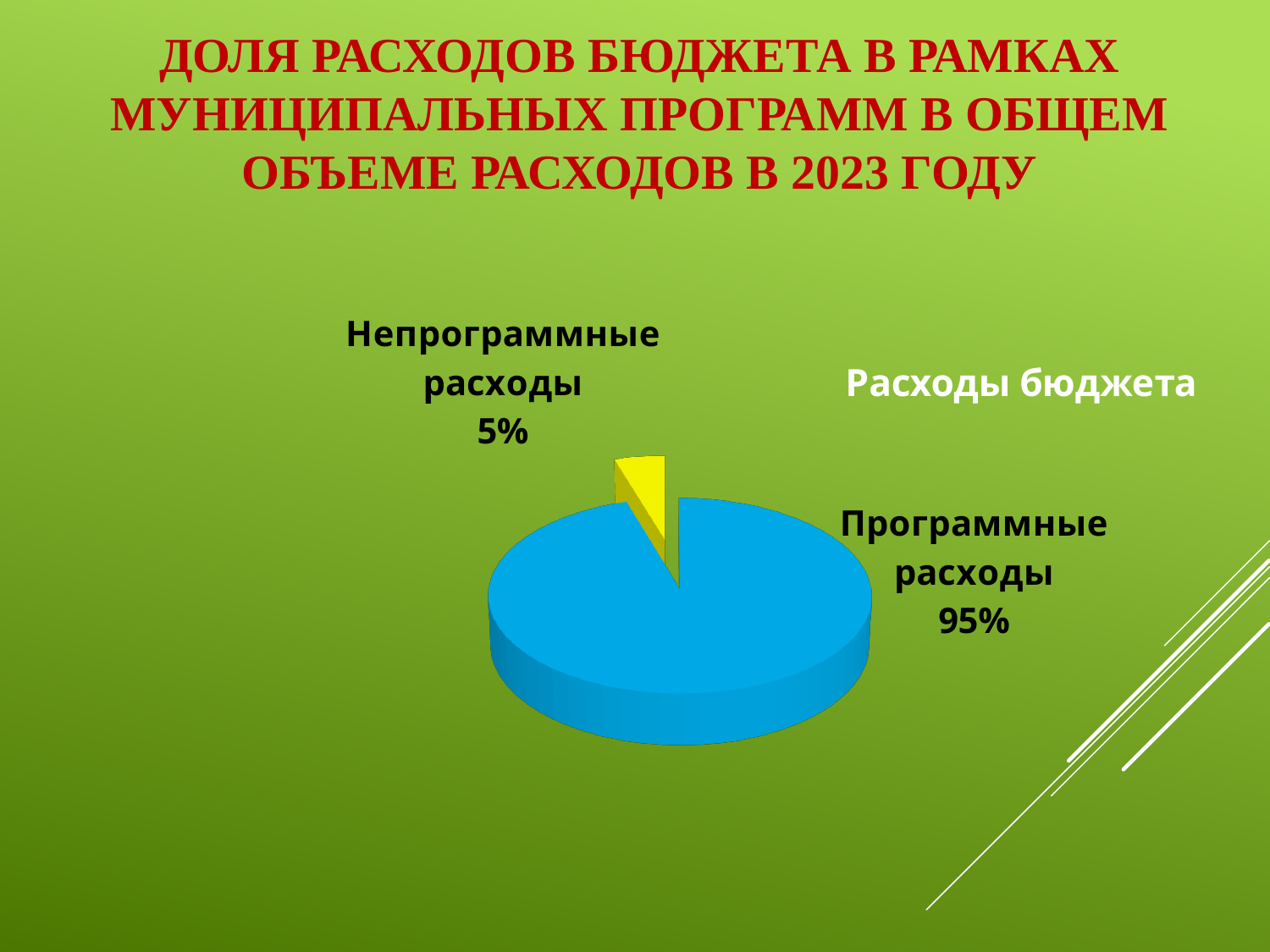
Which category has the smallest slice of the pie? Непрограммные расходы What is the title of the chart? Расходы бюджета What kind of chart is shown on the slide? Pie chart What share of the pie is labelled for Непрограммные расходы? 5% What colour is the slice for Непрограммные расходы? Yellow What is the total of the two labelled shares in the pie? 100% What is the difference in percentage points between Программные расходы and Непрограммные расходы? 90 Which category has the largest slice of the pie? Программные расходы How many slices does the pie chart have? 2 What share of the pie is labelled for Программные расходы? 95% Which is larger: the share for Программные расходы or for Непрограммные расходы? Программные расходы